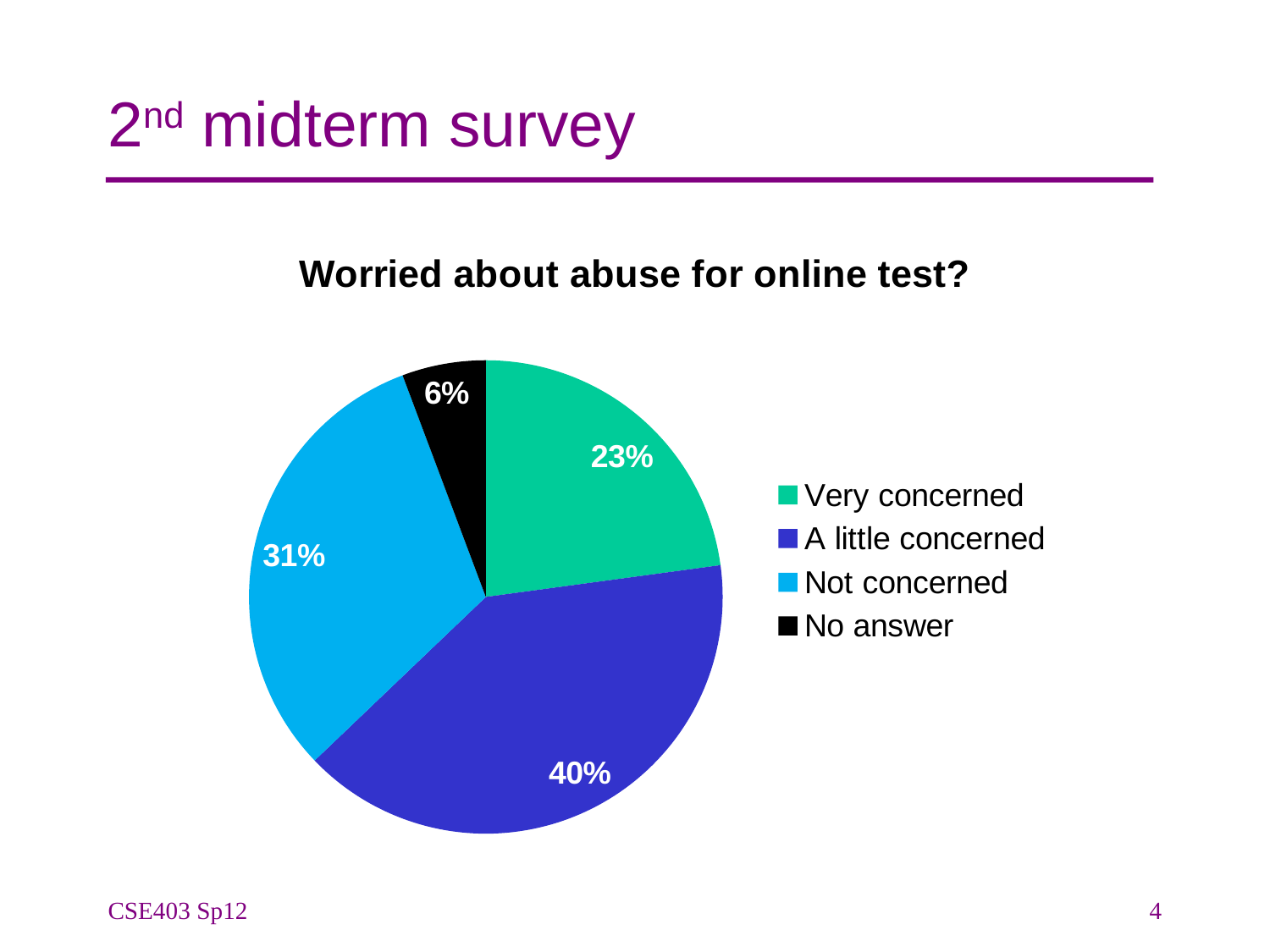
What is the difference in percentage points between 'A little concerned' and 'Very concerned'? 17 What percentage of respondents gave 'No answer'? 6% How many categories does the pie chart show? 4 What percentage of respondents were 'Not concerned'? 31% What kind of chart is shown on the slide? pie chart What is the chart's title? Worried about abuse for online test? What colour is the 'No answer' slice? black What percentage of respondents were 'A little concerned'? 40% What percentage of respondents were 'Very concerned'? 23% Which category has the smallest share of the pie? No answer Which category has the largest share of the pie? A little concerned Which is larger, the share for 'Not concerned' or the share for 'Very concerned'? Not concerned